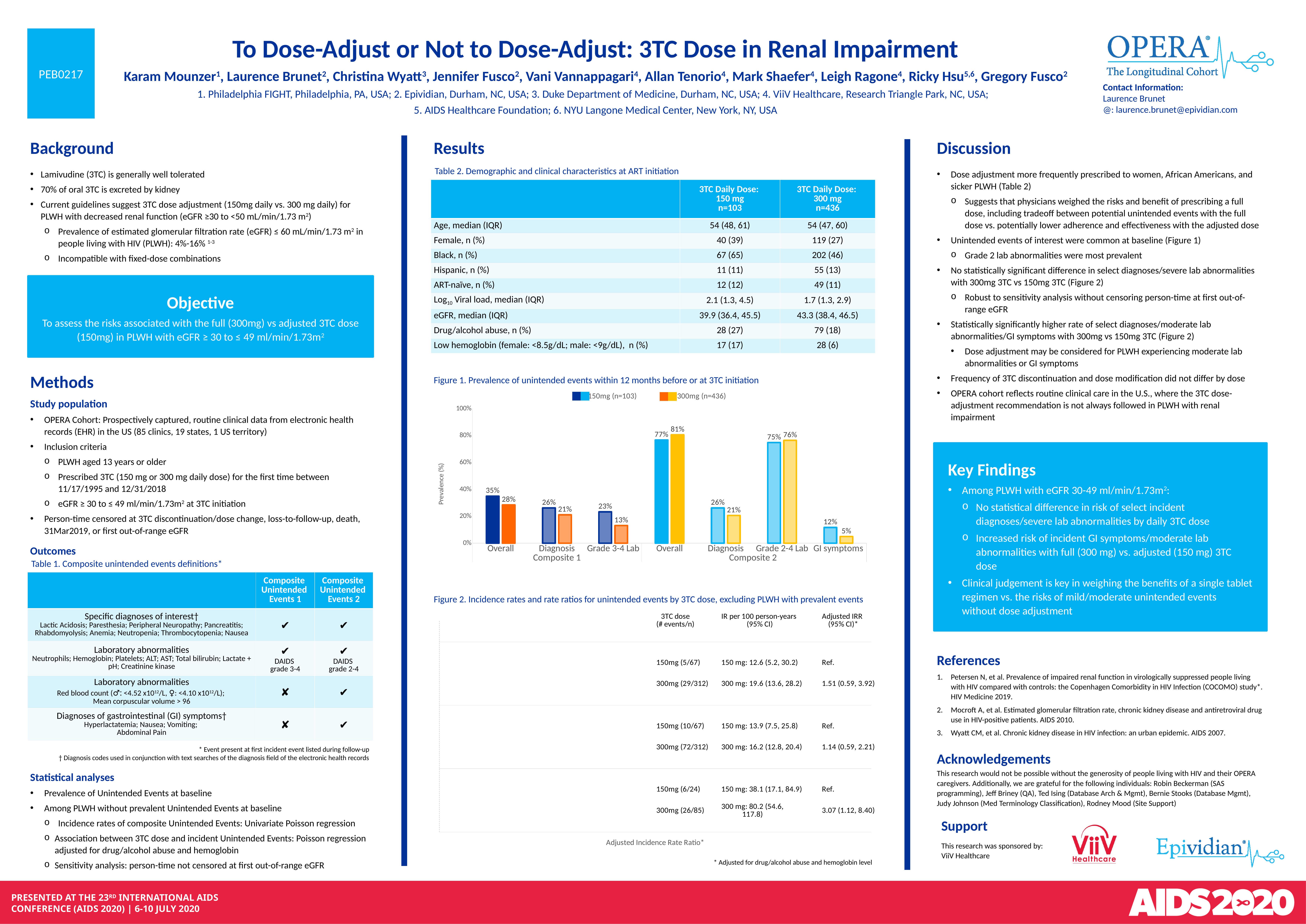
In Figure 1, which group has the higher prevalence of GI symptoms, 150mg or 300mg? 150mg What kind of chart is Figure 1? Bar chart In Figure 1, how many series does the legend list? 2 In Figure 1, what is the prevalence of GI symptoms for the 300mg group? 5% In Figure 1, which category has the lowest prevalence for the 300mg group? GI symptoms In Figure 1, what is the prevalence of Overall unintended events (Composite 2) for the 300mg group? 81% In Figure 1, what is the prevalence of Grade 3-4 Lab abnormalities for the 300mg group? 13% In Figure 1, how many categories are shown on the x axis? 7 In Figure 1, what is the prevalence of Overall unintended events (Composite 1) for the 150mg group? 35% In Figure 1, which category has the highest prevalence for the 150mg group? Overall (Composite 2) In Figure 1, what is the label of the y axis? Prevalence (%) In Figure 1, what is the difference between the 150mg and 300mg prevalence for Grade 3-4 Lab abnormalities? 10%